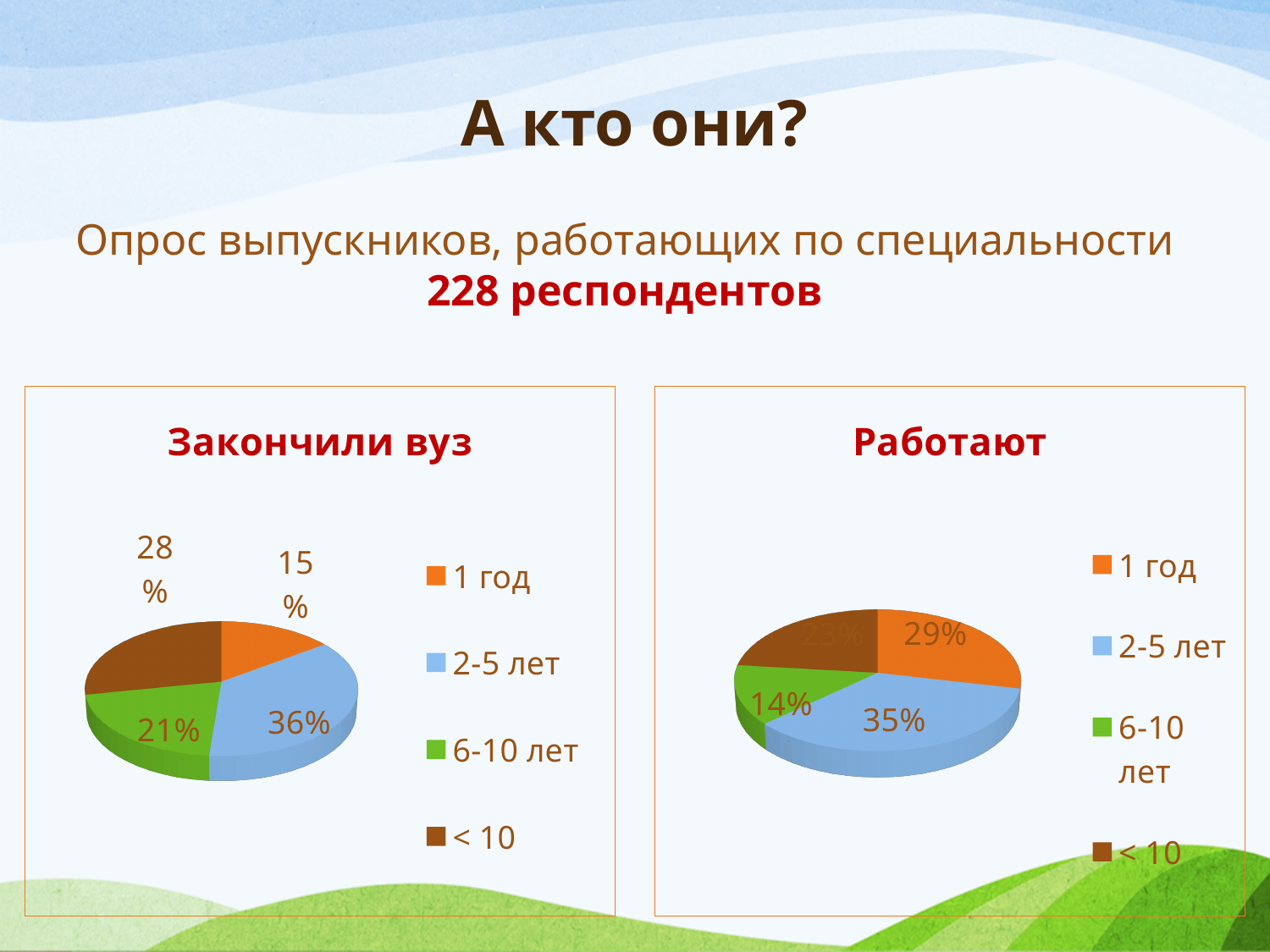
In the chart titled "Работают", which category has the smallest slice? 6-10 лет In the chart titled "Закончили вуз", what share is shown for "1 год"? 15% In the chart titled "Работают", what is the difference in percentage points between "2-5 лет" and "1 год"? 6 In the chart titled "Закончили вуз", which category has the smallest slice? 1 год What type of chart is the chart titled "Закончили вуз"? Pie chart In the chart titled "Работают", which colour represents "1 год"? Orange In the chart titled "Закончили вуз", what share is shown for "2-5 лет"? 36% In the chart titled "Работают", what share is shown for "< 10"? 23% In the chart titled "Закончили вуз", which category has the largest slice? 2-5 лет How many categories does the legend of the chart titled "Работают" list? 4 In the chart titled "Закончили вуз", which is larger: the slice for "< 10" or the slice for "6-10 лет"? < 10 In the chart titled "Работают", what share is shown for "6-10 лет"? 14%